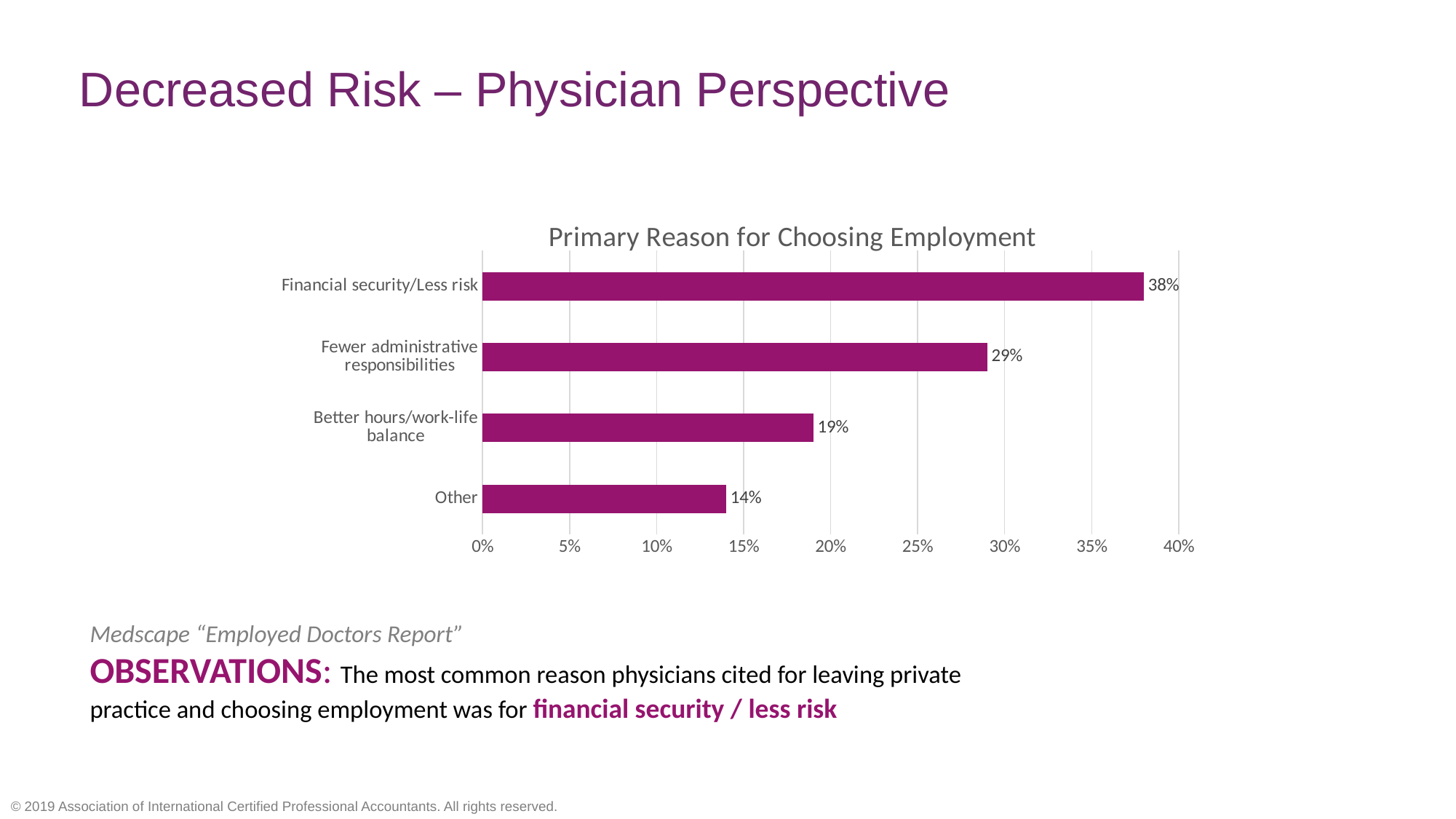
What is the difference between Better hours/work-life balance and Other? 5% Which category has the highest value? Financial security/Less risk What is the title of the chart? Primary Reason for Choosing Employment How many categories are shown in the chart? 4 What is the value for Other? 14% What is the value for Better hours/work-life balance? 19% What kind of chart is shown on the slide? Bar chart What is the difference between Financial security/Less risk and Fewer administrative responsibilities? 9% Which is larger, Fewer administrative responsibilities or Better hours/work-life balance? Fewer administrative responsibilities What is the value for Financial security/Less risk? 38% What is the value for Fewer administrative responsibilities? 29% Which category has the lowest value? Other